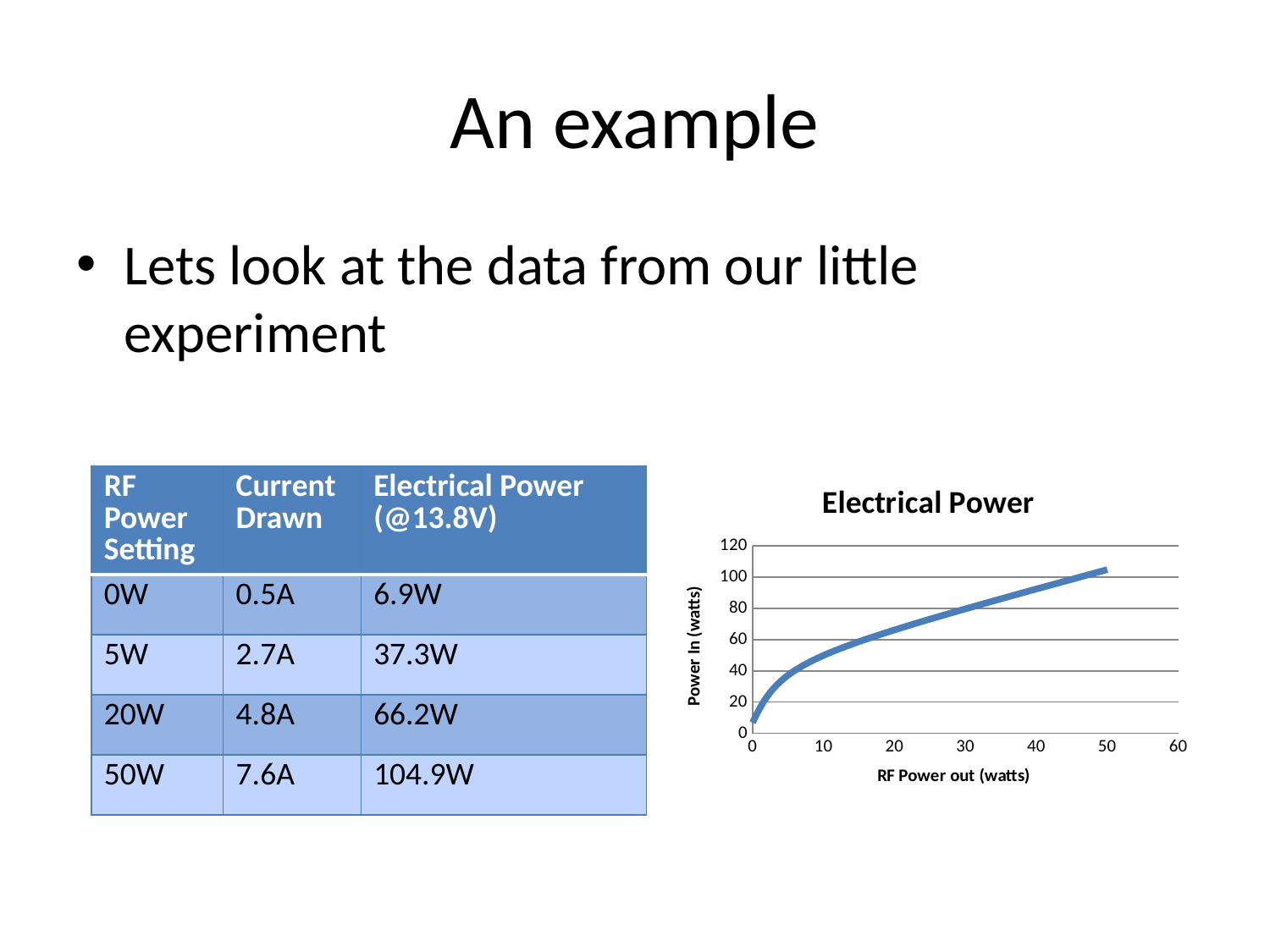
Is the Power In value at 20 watts RF Power out greater or less than 60? greater Is the Power In value at 10 watts RF Power out greater or less than 60? less Does Power In rise or fall as RF Power out increases along the x axis? rise Is the Power In value at 40 watts RF Power out greater or less than 80? greater At which RF Power out value shown on the x axis does the line reach its highest Power In? 50 What is the title of the chart? Electrical Power What kind of chart is shown on the slide? line chart What is the label of the x axis of the chart? RF Power out (watts) Which has the larger Power In value on the chart: 20 watts RF Power out or 50 watts RF Power out? 50 watts